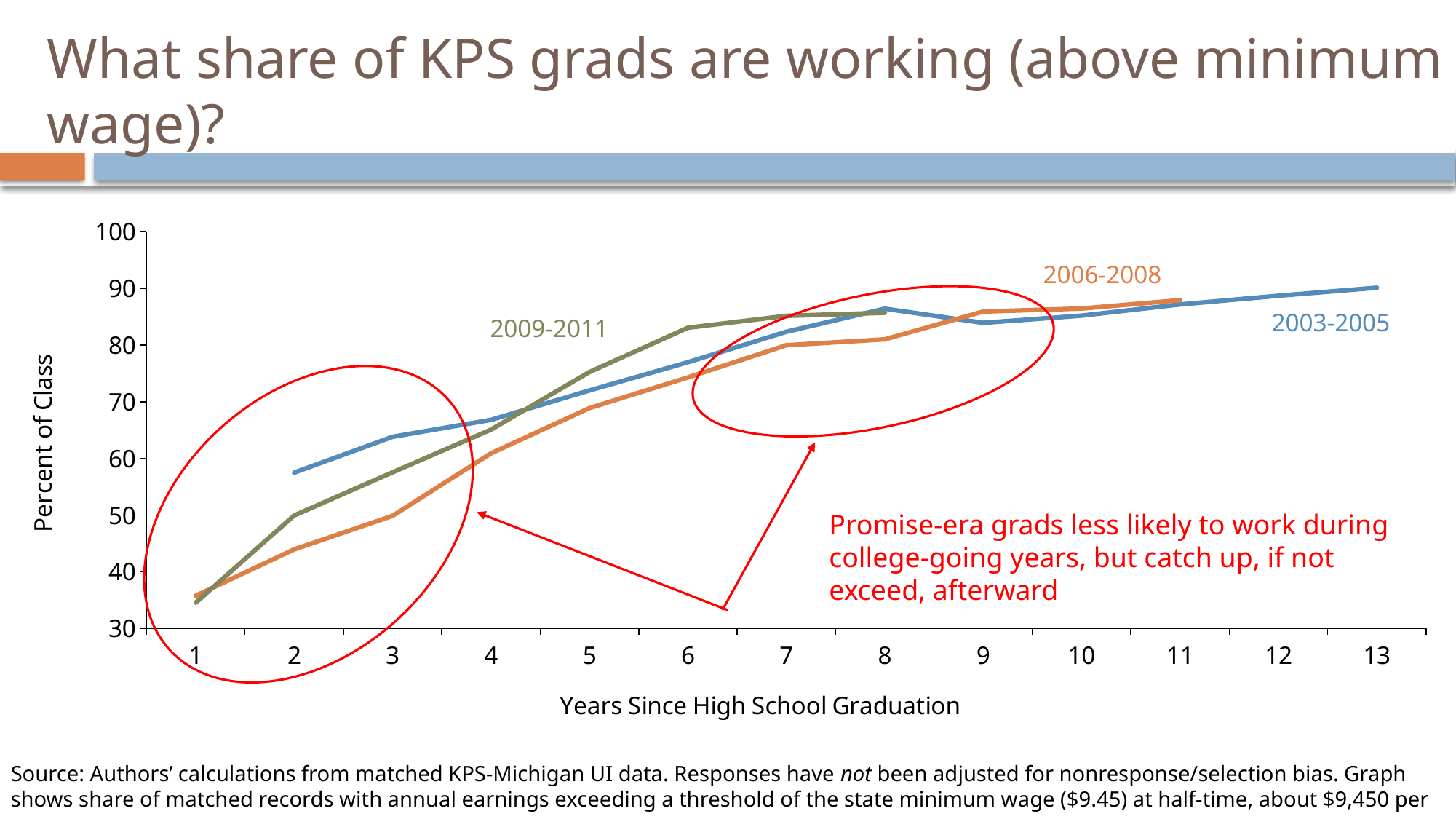
Is the value for the 2009-2011 series at year 6 greater or less than 80? greater At year 2, which series has the higher value: 2003-2005 or 2006-2008? 2003-2005 Is the value for the 2003-2005 series at year 3 greater or less than 60? greater Is the value for the 2006-2008 series at year 9 greater or less than 80? greater How many years since high school graduation are marked on the x axis? 13 How many graduating-class series are plotted on the chart? 3 What kind of chart is shown on the slide? line chart Do the values for the 2003-2005 series generally rise or fall as years since graduation increase? rise At year 6, which series has the higher value: 2009-2011 or 2006-2008? 2009-2011 What is the label on the y axis of the chart? Percent of Class